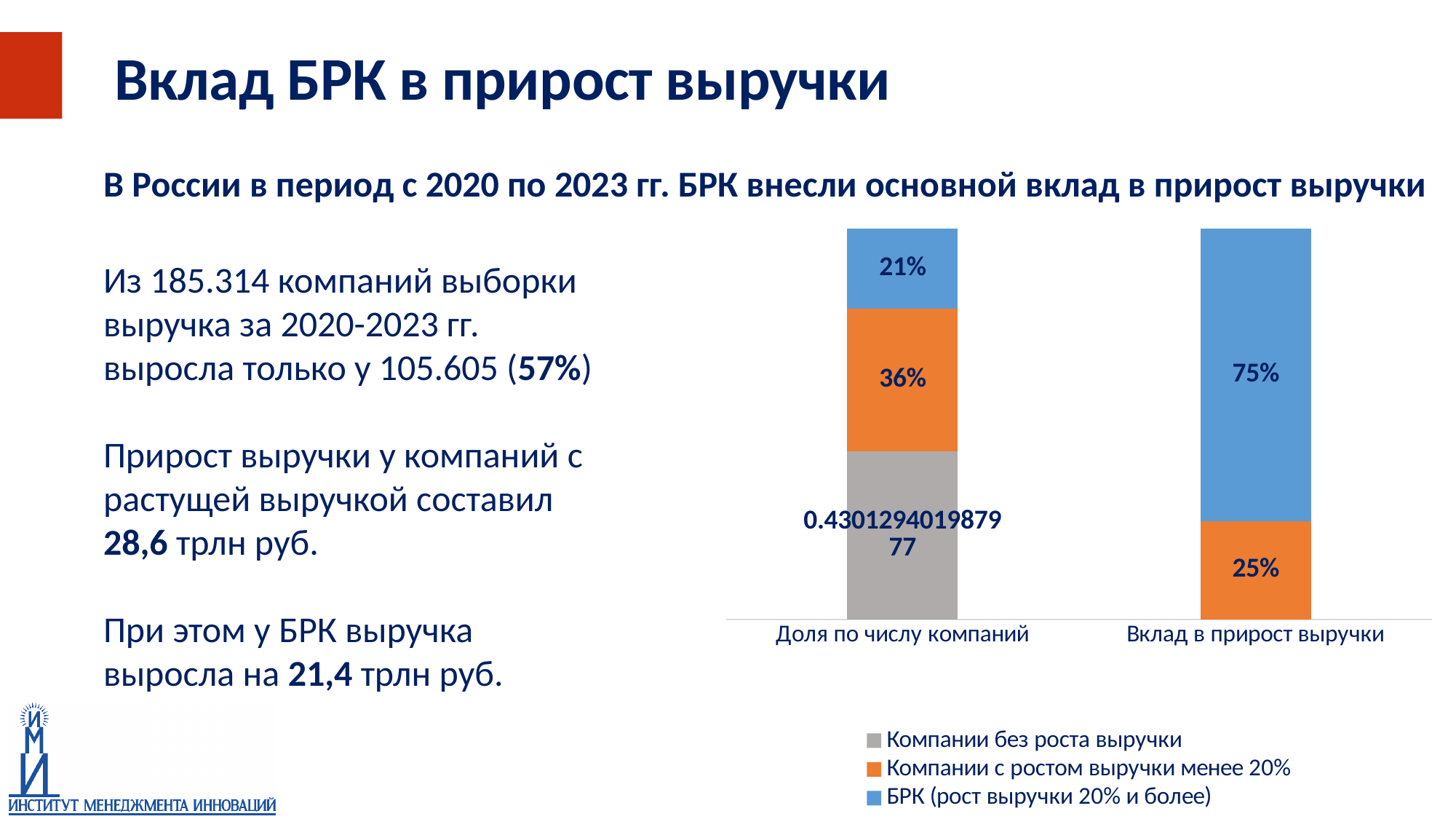
How many series does the legend list? 3 What is the value of the БРК (рост выручки 20% и более) segment in the Вклад в прирост выручки bar? 75% What is the total of the Вклад в прирост выручки stacked bar? 100% What data label is shown on the Компании без роста выручки segment in the Доля по числу компаний bar? 0.430129401987977 How many categories are shown on the x axis? 2 What is the difference between the БРК segment and the Компании с ростом выручки менее 20% segment in the Вклад в прирост выручки bar? 50% What kind of chart is shown on the slide? Stacked bar chart What is the value of the Компании с ростом выручки менее 20% segment in the Вклад в прирост выручки bar? 25% What is the value of the БРК (рост выручки 20% и более) segment in the Доля по числу компаний bar? 21% In the Вклад в прирост выручки bar, which segment is larger: БРК (рост выручки 20% и более) or Компании с ростом выручки менее 20%? БРК (рост выручки 20% и более) What is the value of the Компании с ростом выручки менее 20% segment in the Доля по числу компаний bar? 36% Which colour represents Компании без роста выручки in the legend? Grey